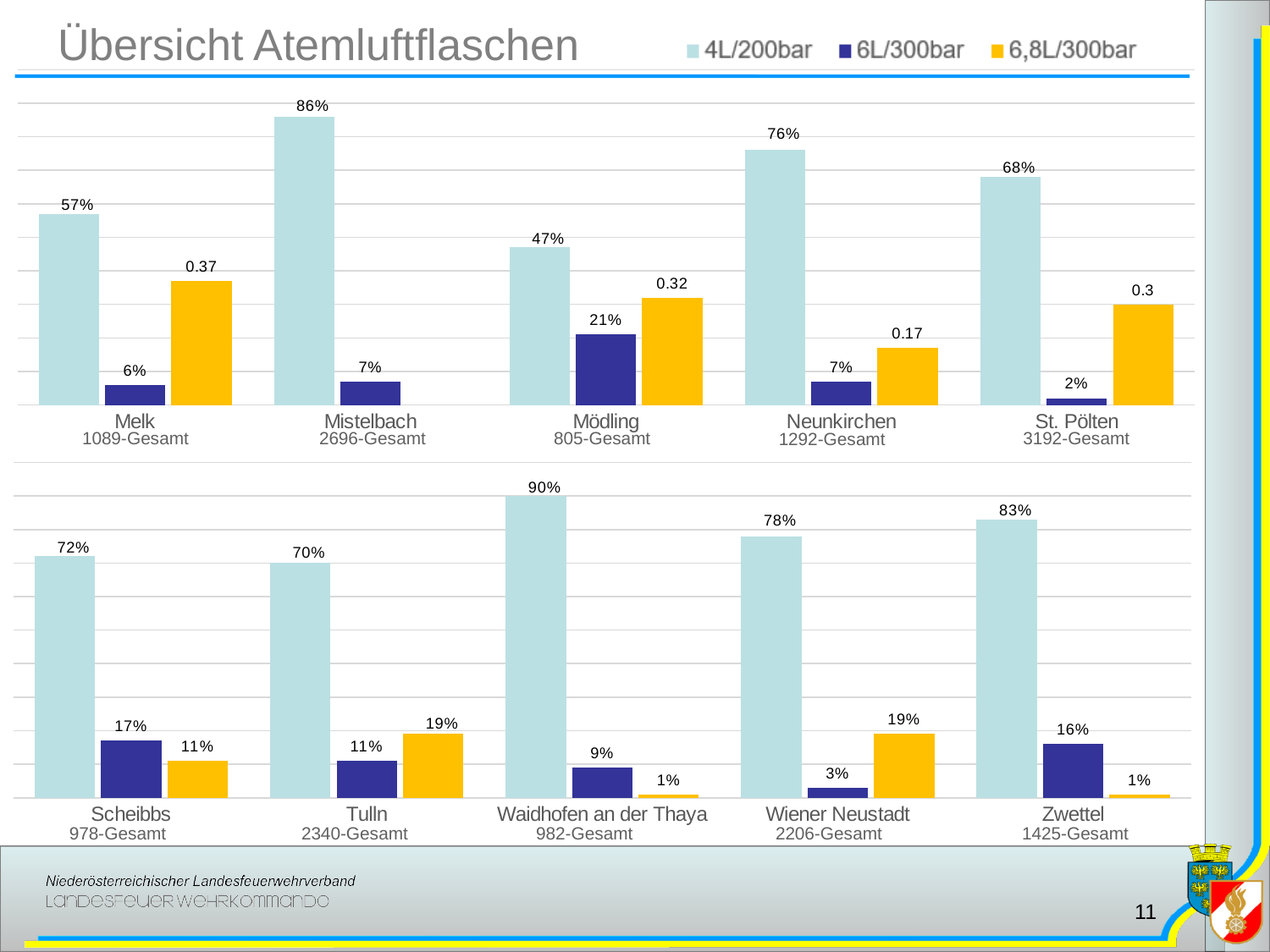
In the bottom chart, what is the value for 6L/300bar in Scheibbs? 17% What is the title of the slide? Übersicht Atemluftflaschen In the bottom chart, what is the value for 6,8L/300bar in Zwettel? 1% In the top chart, what is the difference between the 4L/200bar values for Neunkirchen and Mödling? 29% What kind of chart is the top chart? Bar chart How many series does the legend list? 3 In the top chart, what is the value for 6,8L/300bar in Melk? 0.37 In the bottom chart, which is larger: the 6,8L/300bar value for Tulln or for Scheibbs? Tulln In the top chart, which category has the lowest 6L/300bar value? St. Pölten In the bottom chart, which category has the highest 4L/200bar value? Waidhofen an der Thaya How many categories are shown in the bottom chart? 5 In the top chart, what is the value for 4L/200bar in Mistelbach? 86%